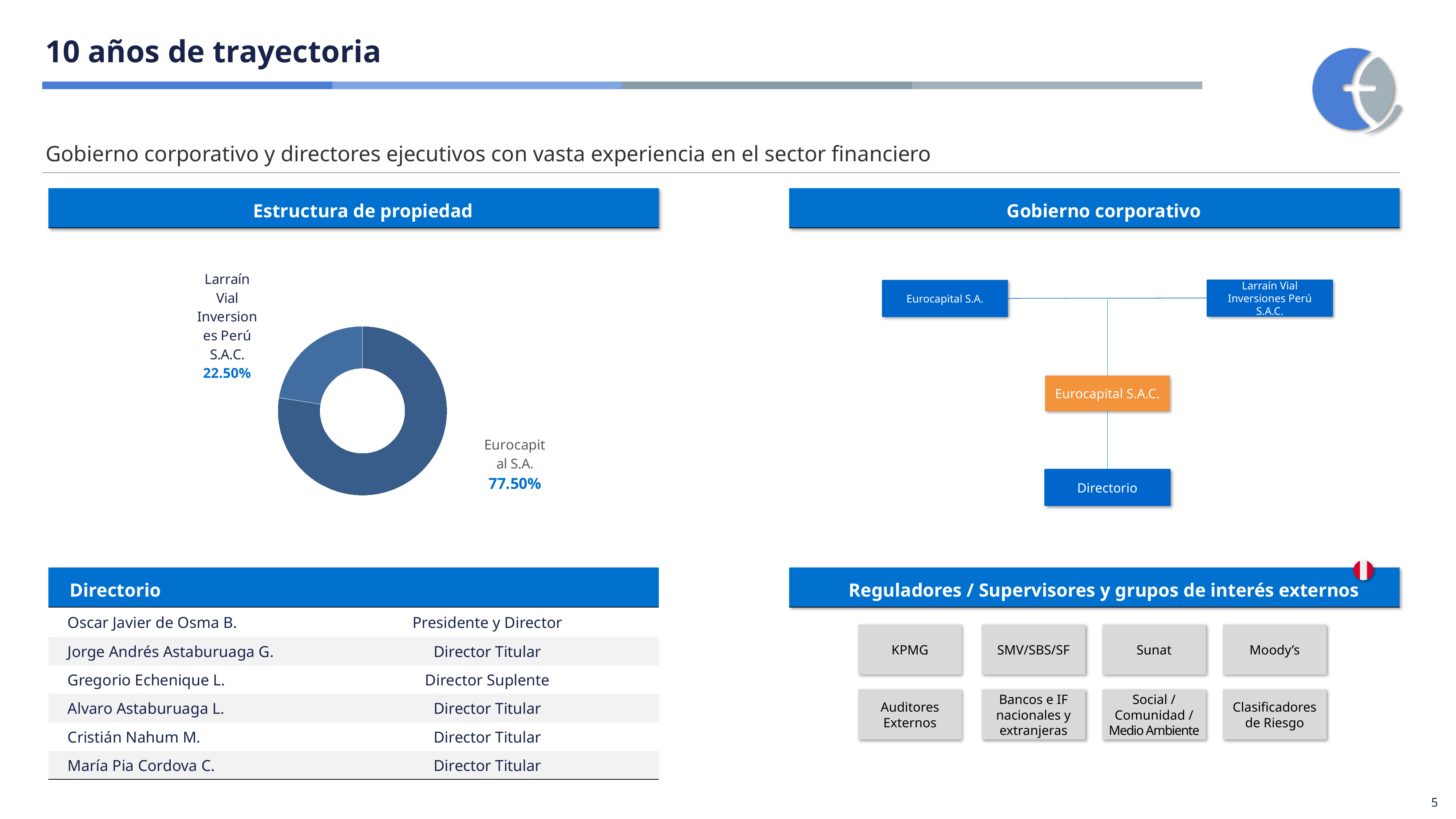
In the "Estructura de propiedad" chart, which is larger: the share of Eurocapital S.A. or that of Larraín Vial Inversiones Perú S.A.C.? Eurocapital S.A. What is the title of the panel containing the doughnut chart? Estructura de propiedad How many slices does the "Estructura de propiedad" chart have? 2 In the "Estructura de propiedad" chart, what share does Larraín Vial Inversiones Perú S.A.C. hold? 22.50% In the "Estructura de propiedad" chart, which shareholder has the largest share? Eurocapital S.A. In the "Estructura de propiedad" chart, what is the difference between the shares of Eurocapital S.A. and Larraín Vial Inversiones Perú S.A.C.? 55.00% In the "Estructura de propiedad" chart, is the share of Larraín Vial Inversiones Perú S.A.C. greater or less than 25%? less In the "Estructura de propiedad" chart, what share does Eurocapital S.A. hold? 77.50% What kind of chart is shown under "Estructura de propiedad"? Doughnut (pie) chart In the "Estructura de propiedad" chart, what is the total of the two shares shown? 100.00% In the "Estructura de propiedad" chart, which shareholder has the smallest share? Larraín Vial Inversiones Perú S.A.C.